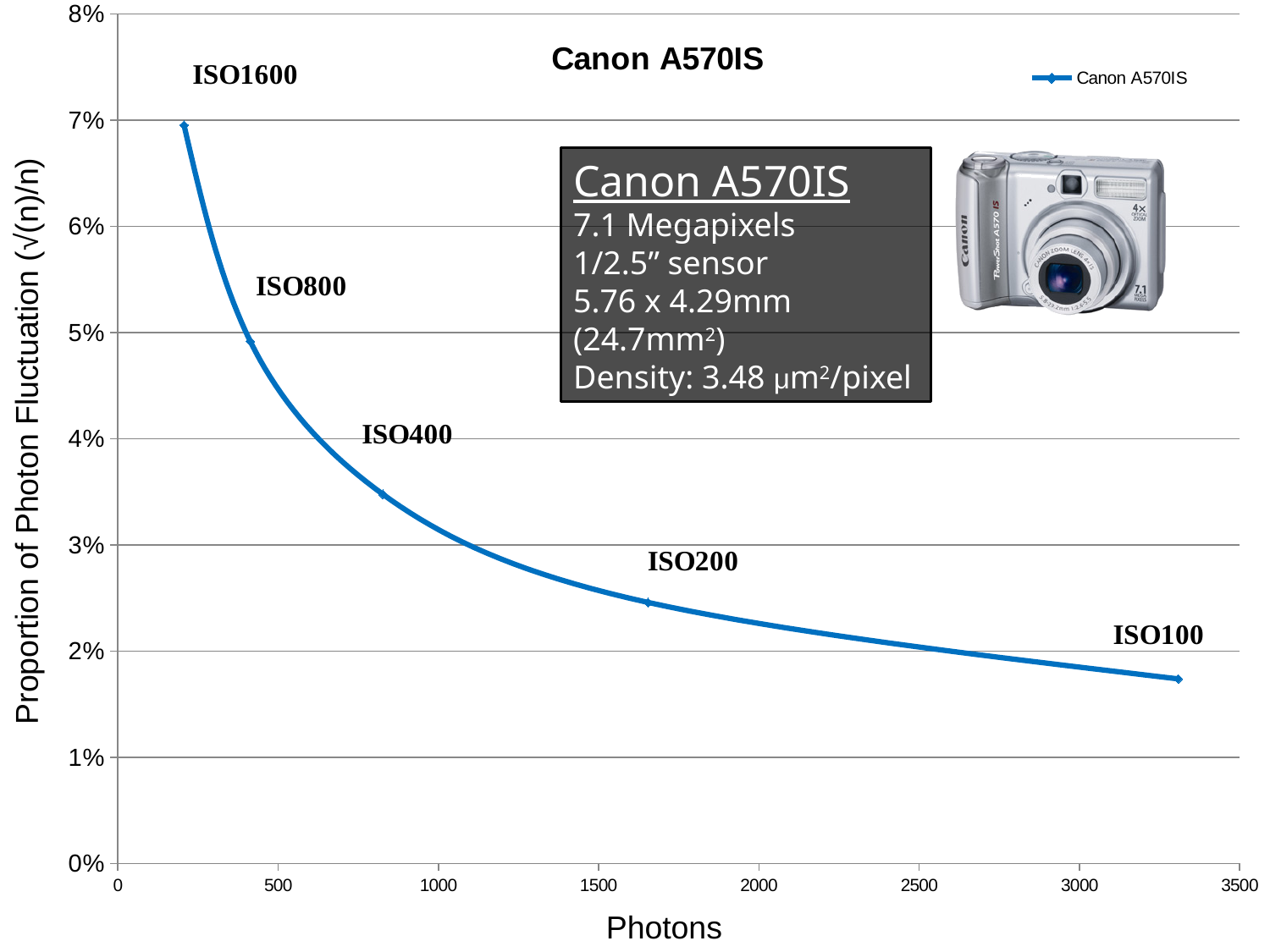
Is the value for ISO1600 greater or less than 6%? greater What kind of chart is shown on the slide? line chart How many labelled ISO data points are plotted on the line? 5 As the number of photons increases along the x axis, does the proportion of photon fluctuation rise or fall? fall Which ISO setting has the lowest proportion of photon fluctuation? ISO100 How many series does the legend list? 1 What is the title of the chart? Canon A570IS Is the value for ISO100 greater or less than 2%? less Is the value for ISO400 greater or less than 4%? less Which ISO setting has the highest proportion of photon fluctuation? ISO1600 Which has a higher proportion of photon fluctuation, ISO400 or ISO200? ISO400